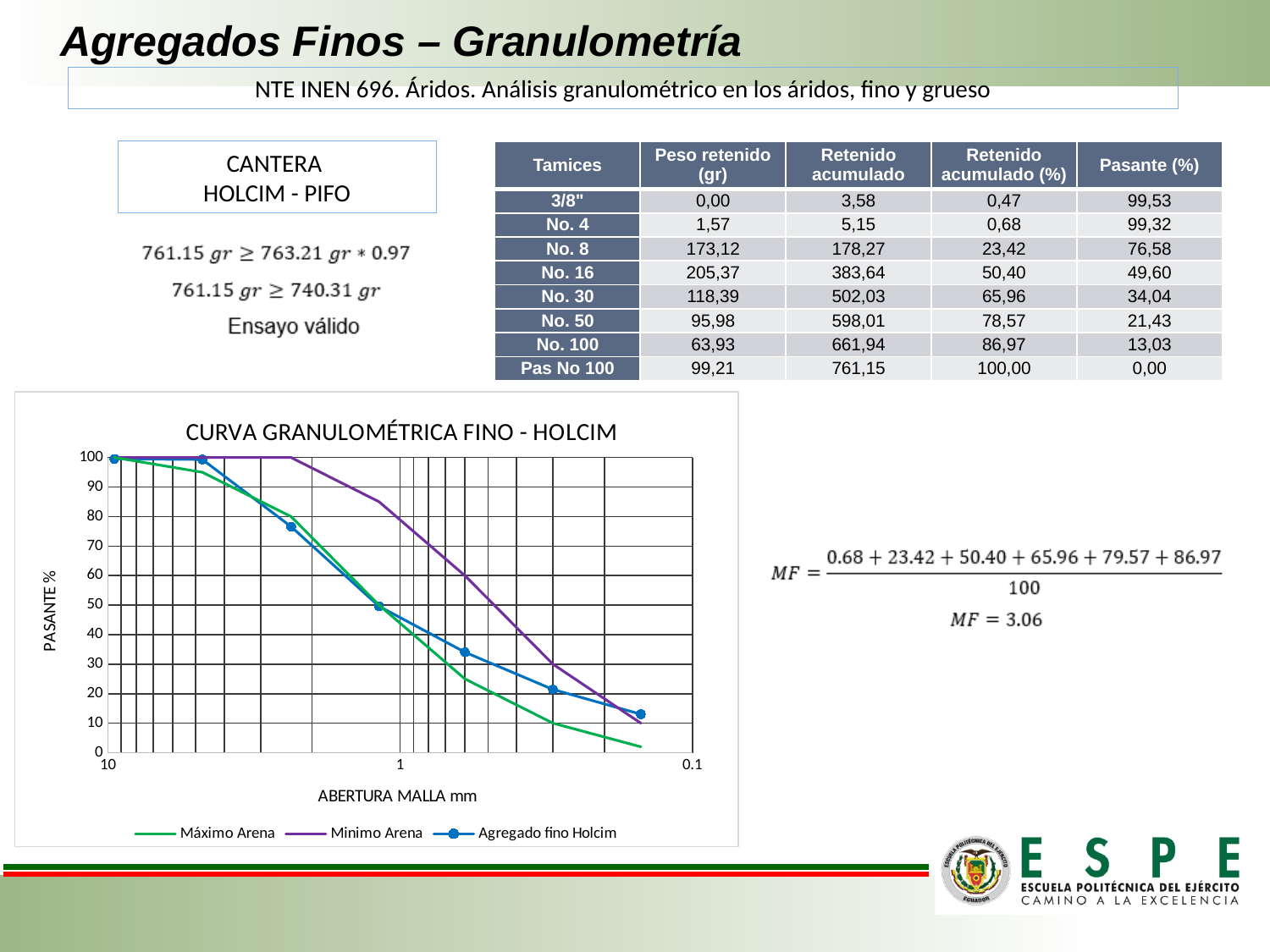
How many series does the legend of the chart list? 3 What is the label of the y axis of the chart? PASANTE % Do the values of the Agregado fino Holcim series rise or fall from left to right along the x axis? fall At an abertura malla of 1 mm, is the value for Máximo Arena greater or less than 50? less At an abertura malla of 1 mm, which series has the larger value, Minimo Arena or Máximo Arena? Minimo Arena What is the title of the chart? CURVA GRANULOMÉTRICA FINO - HOLCIM Which series has the highest value at an abertura malla of 1 mm? Minimo Arena What kind of chart is shown on the slide? line chart